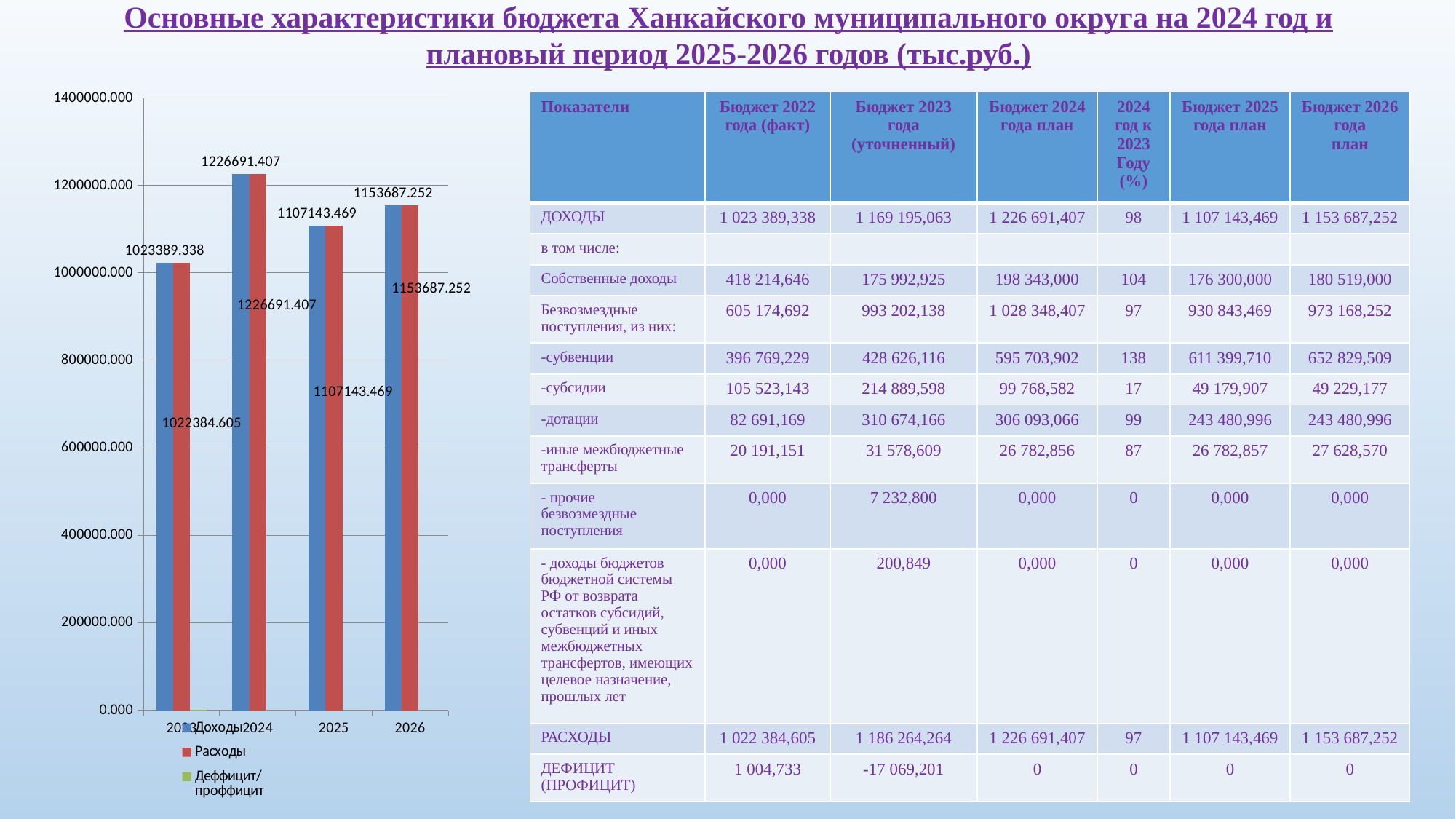
In which year is the Доходы bar highest in the chart? 2024 How many series does the chart legend list? 3 What is the value of Расходы for 2025 in the chart? 1107143.469 Is the value of Расходы for 2026 greater or less than 1000000.000? greater What is the value of Доходы for 2026 in the chart? 1153687.252 What is the difference between the Доходы values for 2024 and 2025 in the chart? 119547.938 How many year categories are shown on the x axis of the chart? 4 What is the difference between the Расходы values for 2026 and 2025 in the chart? 46543.783 What is the value of Доходы for 2024 in the chart? 1226691.407 Which year has the larger Доходы value in the chart, 2025 or 2026? 2026 What colour are the Расходы bars in the chart? red What kind of chart is shown on the left of the slide? bar chart